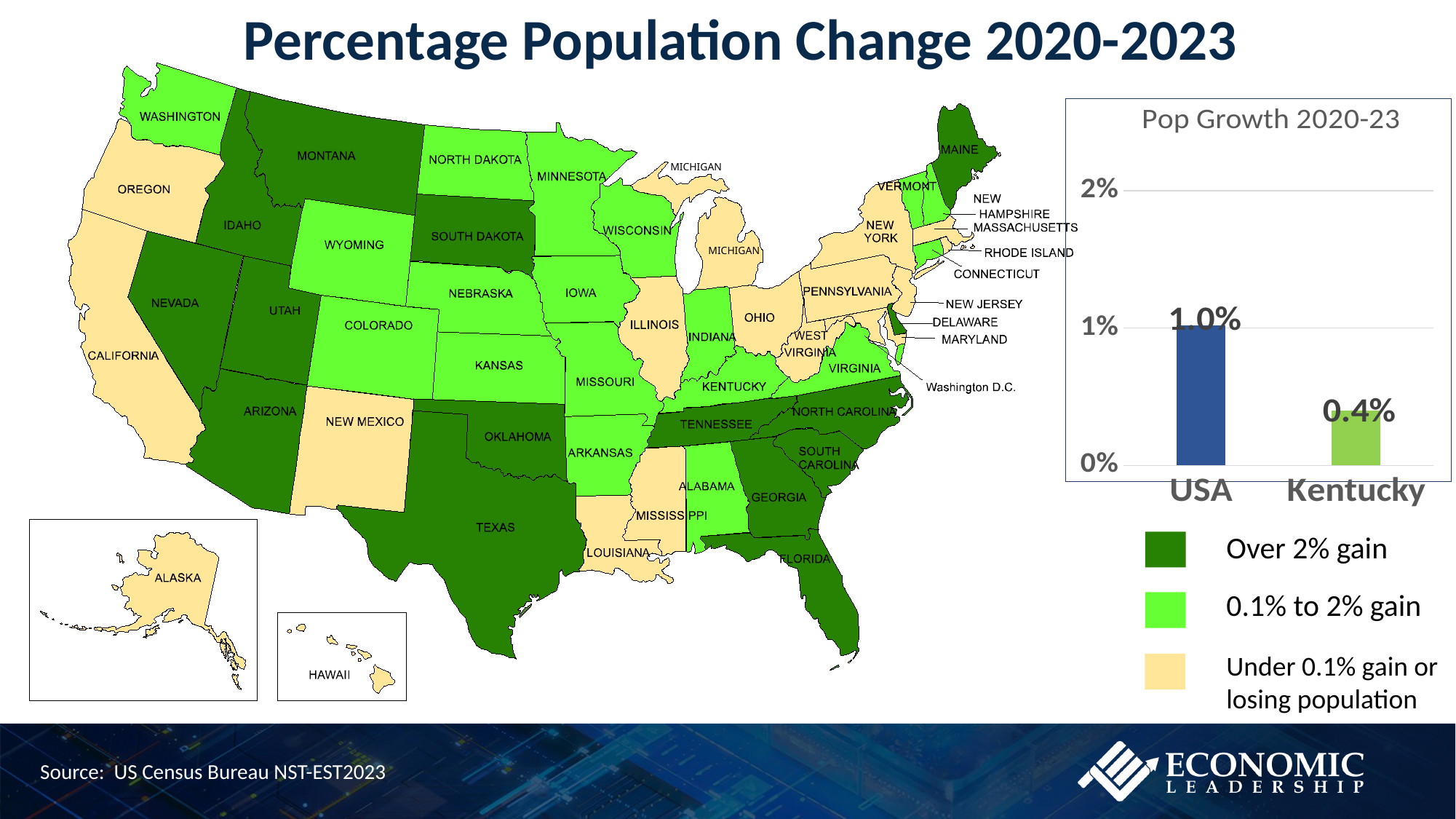
In the Pop Growth 2020-23 chart, what is the value for Kentucky? 0.4% In the Pop Growth 2020-23 chart, which category has the highest value? USA In the Pop Growth 2020-23 chart, what is the difference between the USA and Kentucky values? 0.6% In the Pop Growth 2020-23 chart, is the value for Kentucky greater or less than 1%? less On the map, what does the darkest green colour represent according to the legend? Over 2% gain How many categories are shown in the Pop Growth 2020-23 chart? 2 In the Pop Growth 2020-23 chart, is the value for USA or Kentucky larger? USA What is the title of the bar chart on the right side of the slide? Pop Growth 2020-23 In the Pop Growth 2020-23 chart, is the value for USA greater or less than 2%? less In the Pop Growth 2020-23 chart, what is the value for USA? 1.0% What kind of chart is the Pop Growth 2020-23 chart? bar chart In the Pop Growth 2020-23 chart, which category has the lowest value? Kentucky